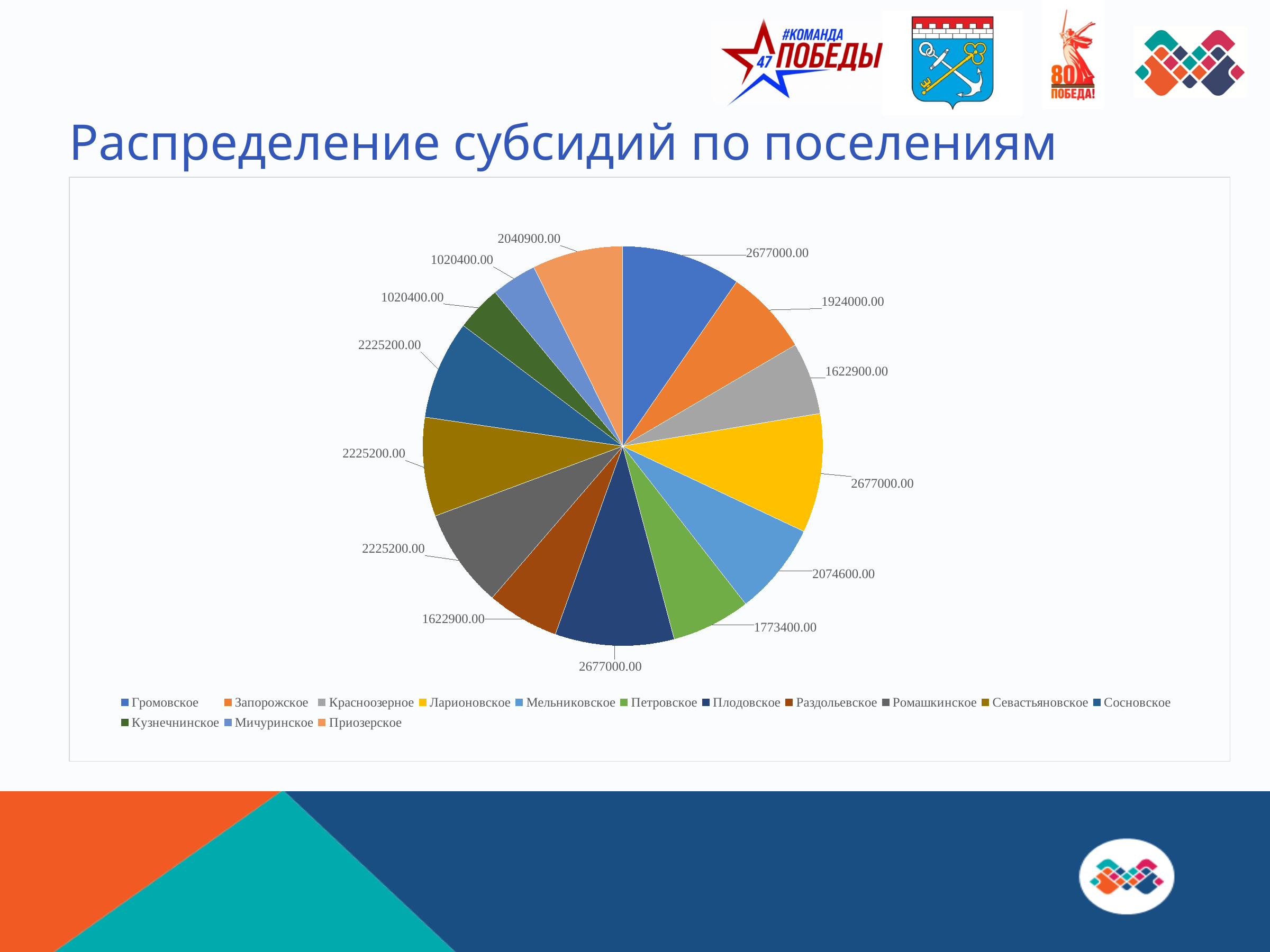
How many categories does the pie chart show? 14 What is the value for Петровское? 1773400.00 What is the value for Кузнечнинское? 1020400.00 What is the value for Запорожское? 1924000.00 What is the value for Мельниковское? 2074600.00 What is the difference between the values for Запорожское and Красноозерное? 301100.00 Which is larger, the value for Мельниковское or the value for Петровское? Мельниковское What is the value for Приозерское? 2040900.00 What is the smallest value shown on the pie chart? 1020400.00 What is the value for Громовское? 2677000.00 What is the largest value shown on the pie chart? 2677000.00 What kind of chart is shown on the slide? Pie chart